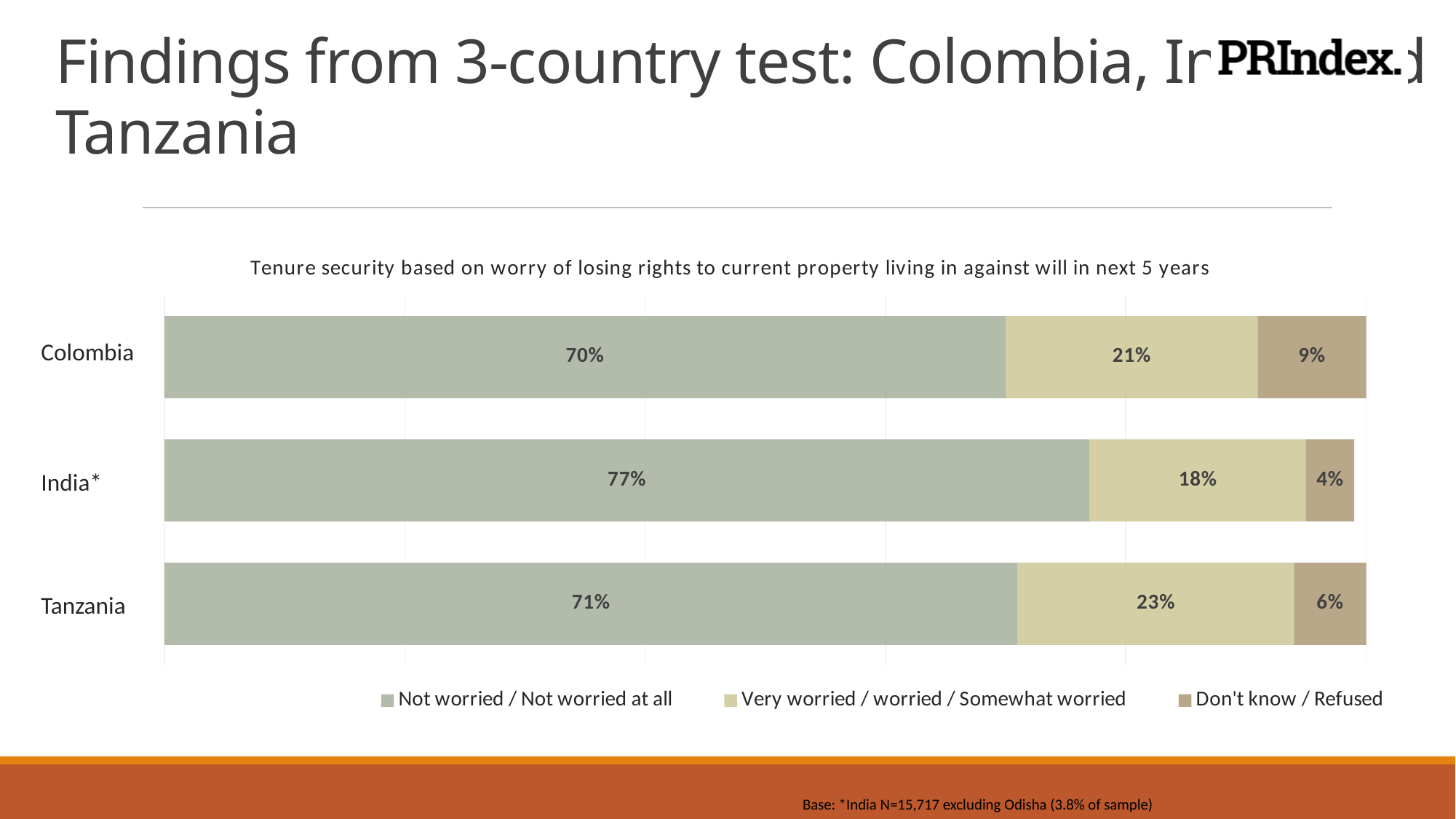
Which is larger: the 'Don't know / Refused' value for Colombia or for Tanzania? Colombia What percentage of respondents in Colombia are 'Not worried / Not worried at all'? 70% Which country has the highest 'Not worried / Not worried at all' share? India* How many countries are shown in the chart? 3 What is the 'Don't know / Refused' value for Tanzania? 6% How many series does the legend list? 3 What kind of chart is shown on the slide? Stacked bar chart What is the total of the three segments for the India* bar? 99% What is the title of the chart? Tenure security based on worry of losing rights to current property living in against will in next 5 years What is the difference between the 'Very worried / worried / Somewhat worried' values for Tanzania and Colombia? 2% Which country has the lowest 'Don't know / Refused' share? India* What percentage of respondents in India* are 'Very worried / worried / Somewhat worried'? 18%